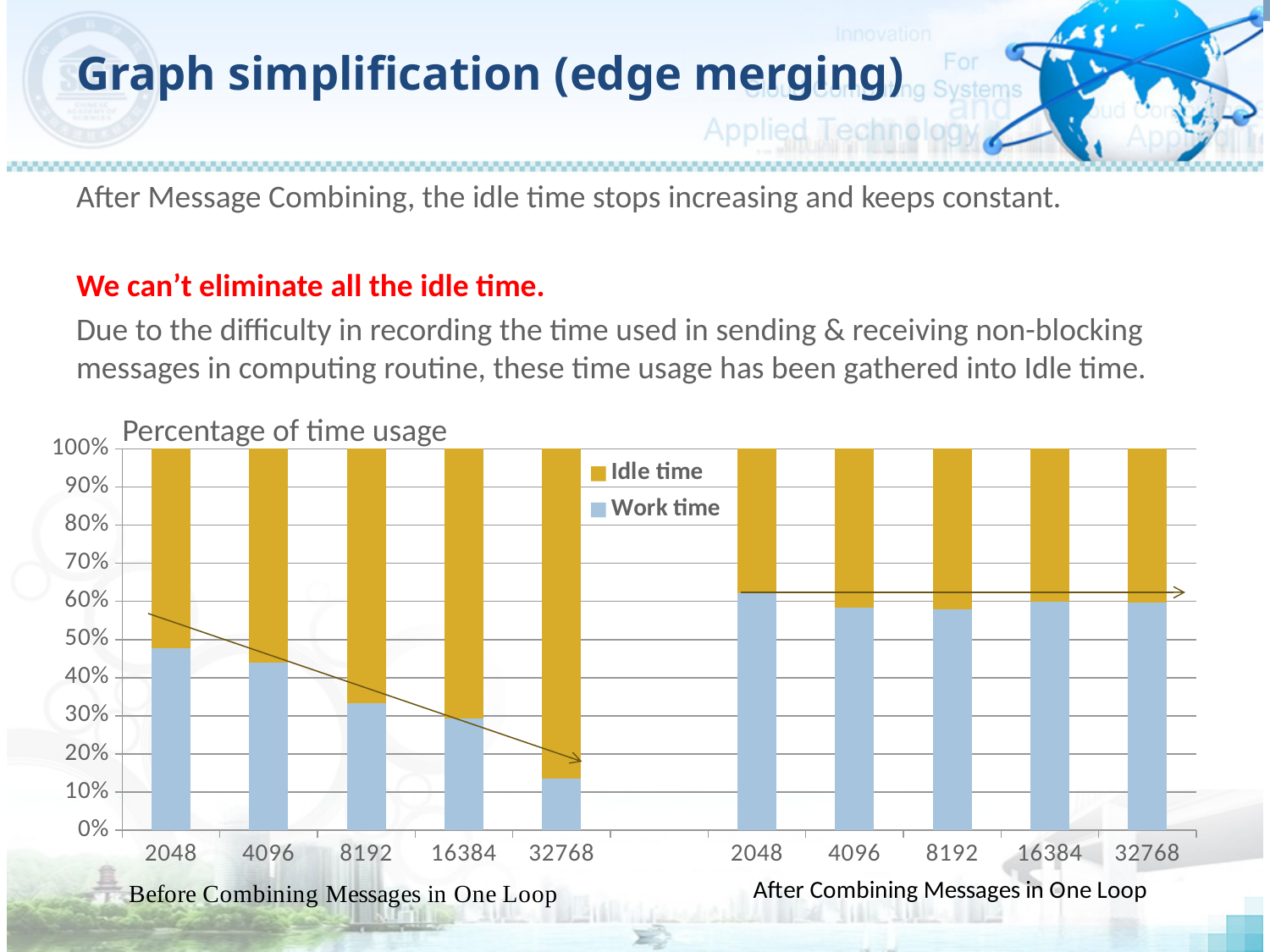
What kind of chart is shown on the slide? stacked bar chart What is the title of the chart? Percentage of time usage Which two series are listed in the chart legend? Idle time and Work time In the 'Before Combining Messages in One Loop' group, which category has the lowest Work time share? 32768 In the 'Before Combining Messages in One Loop' group, is the Work time value for 32768 greater or less than 20%? less Which is larger: the Work time share for 32768 before combining messages, or the Work time share for 32768 after combining messages? after combining messages How many bars are plotted in the chart in total? 10 In the 'Before Combining Messages in One Loop' group, does the Work time share rise or fall as the x-axis value increases from 2048 to 32768? fall In the 'Before Combining Messages in One Loop' group, which category has the highest Work time share? 2048 In the 'Before Combining Messages in One Loop' group, is the Work time value for 2048 greater or less than 40%? greater In the 'After Combining Messages in One Loop' group, is the Work time value for 2048 greater or less than 50%? greater How many series does the chart legend list? 2